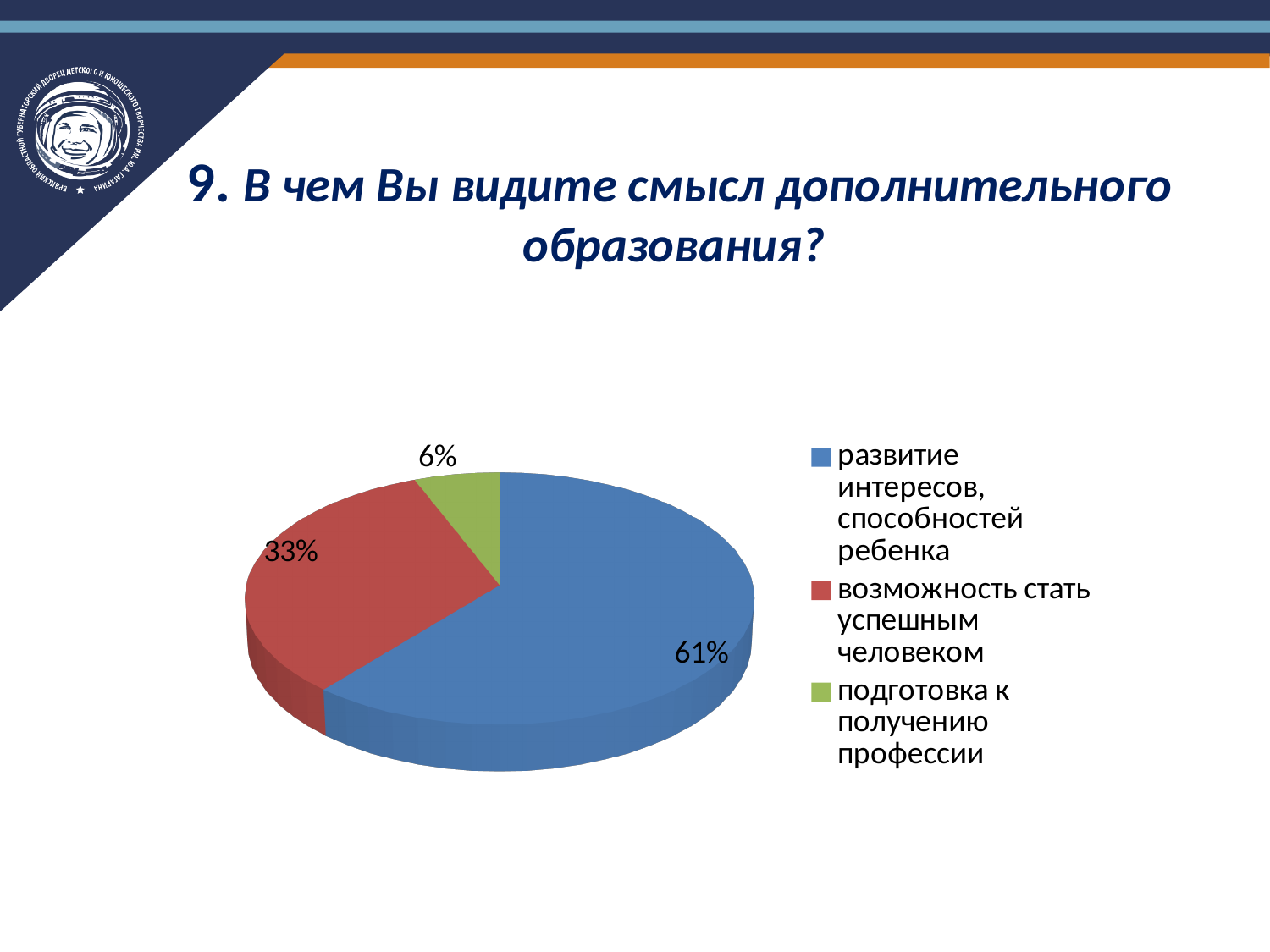
What is the title of the slide above the chart? 9. В чем Вы видите смысл дополнительного образования? How many entries does the legend list? 3 Which is larger: the slice for 'возможность стать успешным человеком' or the slice for 'подготовка к получению профессии'? возможность стать успешным человеком What share of the pie is labelled for 'возможность стать успешным человеком'? 33% What is the difference in percentage points between the slices for 'развитие интересов, способностей ребенка' and 'возможность стать успешным человеком'? 28 Which category has the smallest slice of the pie? подготовка к получению профессии What colour is the slice for 'возможность стать успешным человеком'? red How many slices does the pie chart have? 3 What share of the pie is labelled for 'развитие интересов, способностей ребенка'? 61% What kind of chart is shown on the slide? pie chart What share of the pie is labelled for 'подготовка к получению профессии'? 6% Which category has the largest slice of the pie? развитие интересов, способностей ребенка